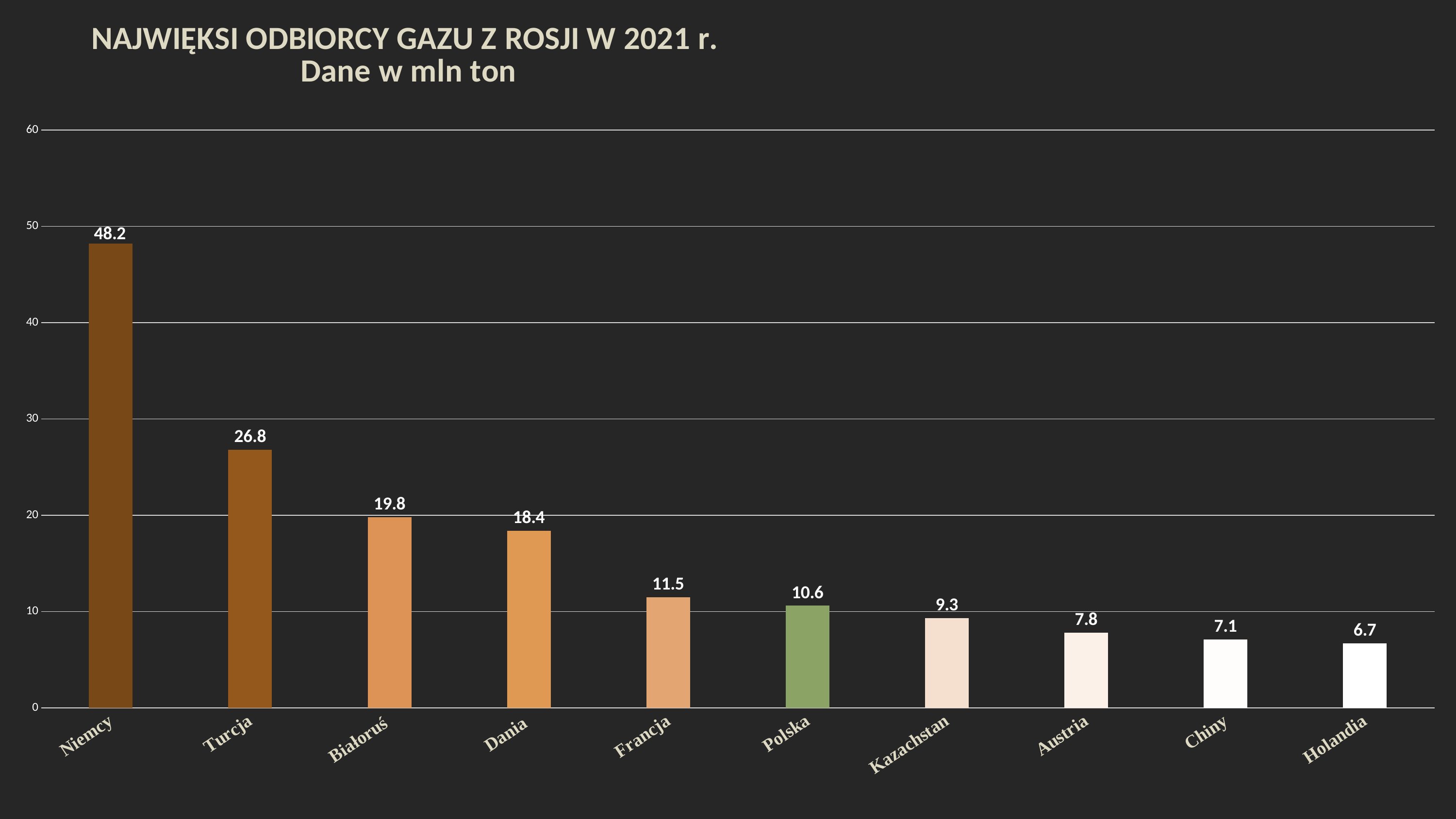
Which country has the highest value? Niemcy Which country has the lowest value? Holandia What is the value for Niemcy? 48.2 Which is larger, the value for Francja or the value for Austria? Francja What kind of chart is shown on the slide? bar chart What is the value for Polska? 10.6 Is the value for Turcja greater or less than 30? less What is the value for Kazachstan? 9.3 How many countries are shown in the chart? 10 What is the difference between the values for Białoruś and Dania? 1.4 Do the values rise or fall from left to right along the x axis? fall What is the difference between the values for Niemcy and Turcja? 21.4